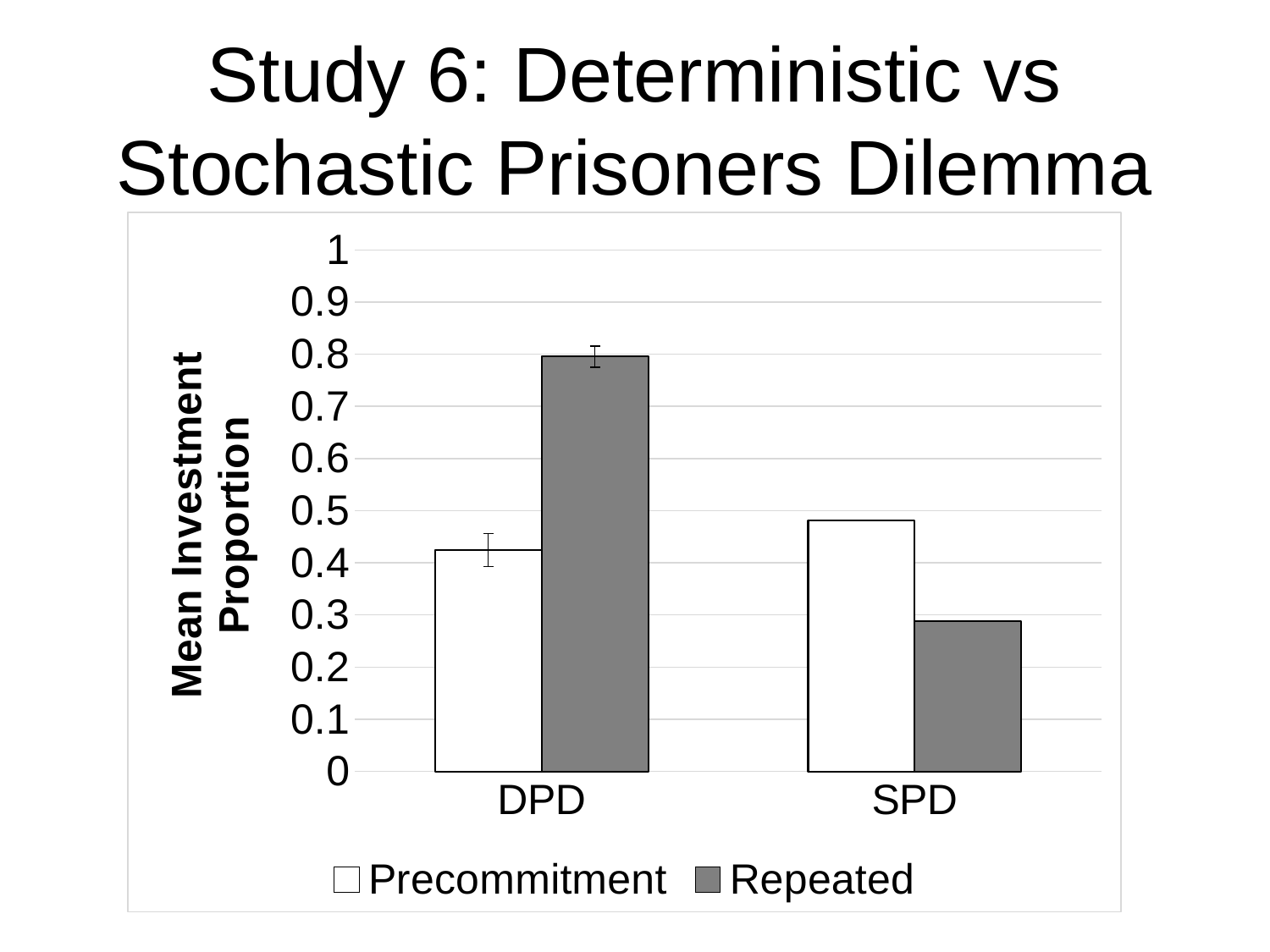
Is the value for Repeated in SPD greater or less than 0.4? less Which bar is the tallest in the chart? Repeated in DPD How many series does the legend list? 2 What is the label of the y axis? Mean Investment Proportion Is the value for Precommitment in DPD greater or less than 0.5? less Is the value for Repeated in DPD greater or less than 0.7? greater How many categories are shown on the x axis? 2 In the SPD category, which series has the larger value, Precommitment or Repeated? Precommitment In the DPD category, which series has the larger value, Precommitment or Repeated? Repeated What are the two series named in the legend? Precommitment and Repeated What kind of chart is shown on the slide? bar chart